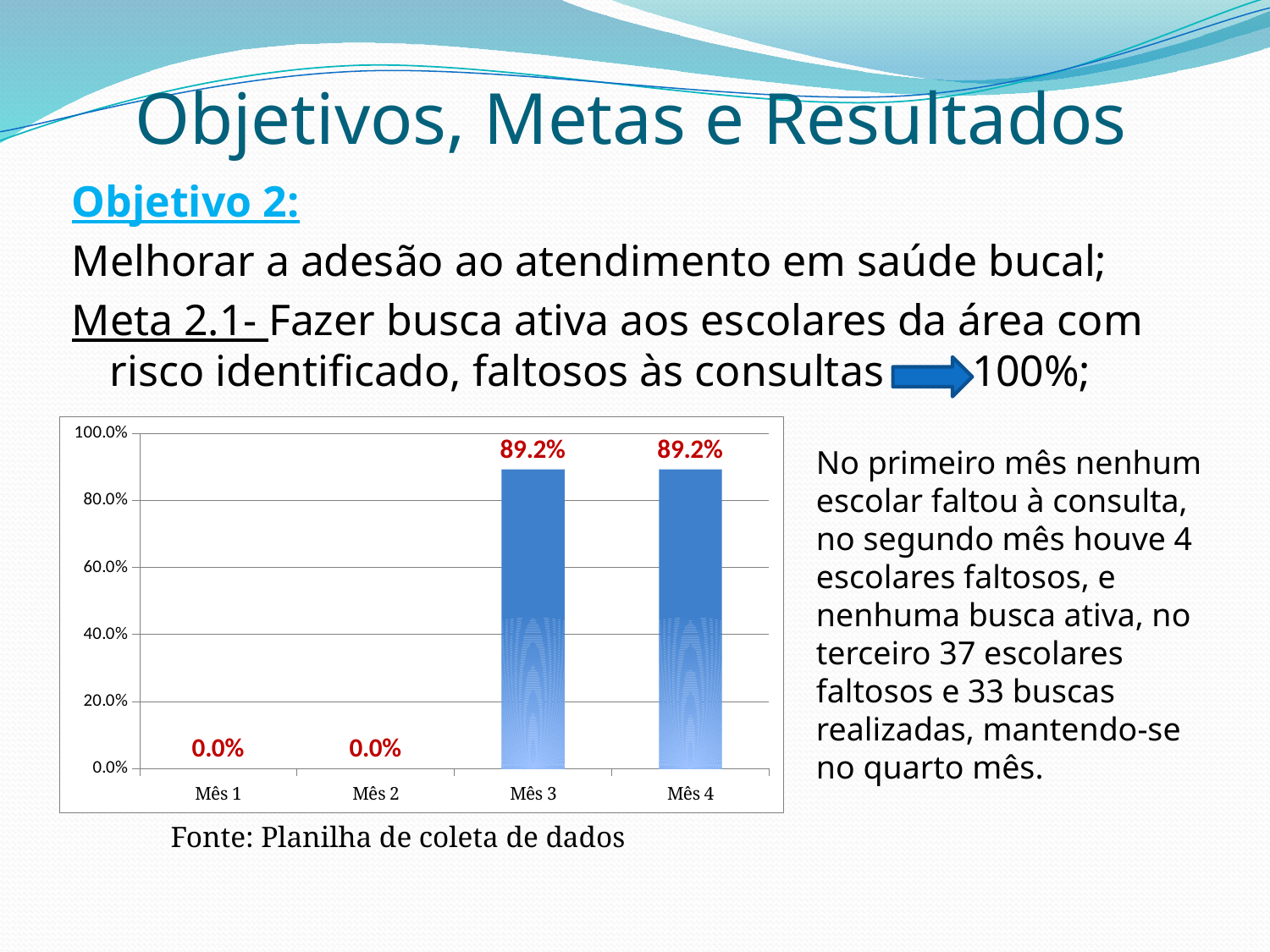
What kind of chart is shown on the slide? Bar chart What is the value shown for Mês 2? 0.0% What is the difference between the value for Mês 3 and the value for Mês 1? 89.2% What is the highest tick label on the chart's vertical axis? 100.0% Do the values rise or fall from Mês 1 to Mês 4? rise How many categories (months) are shown on the x axis of the chart? 4 What is the value shown for Mês 4? 89.2% What source is cited below the chart? Fonte: Planilha de coleta de dados Is the value for Mês 3 greater or less than 80.0%? greater What is the value shown for Mês 3? 89.2% What is the value shown for Mês 1? 0.0% Which is larger, the value for Mês 2 or the value for Mês 3? Mês 3